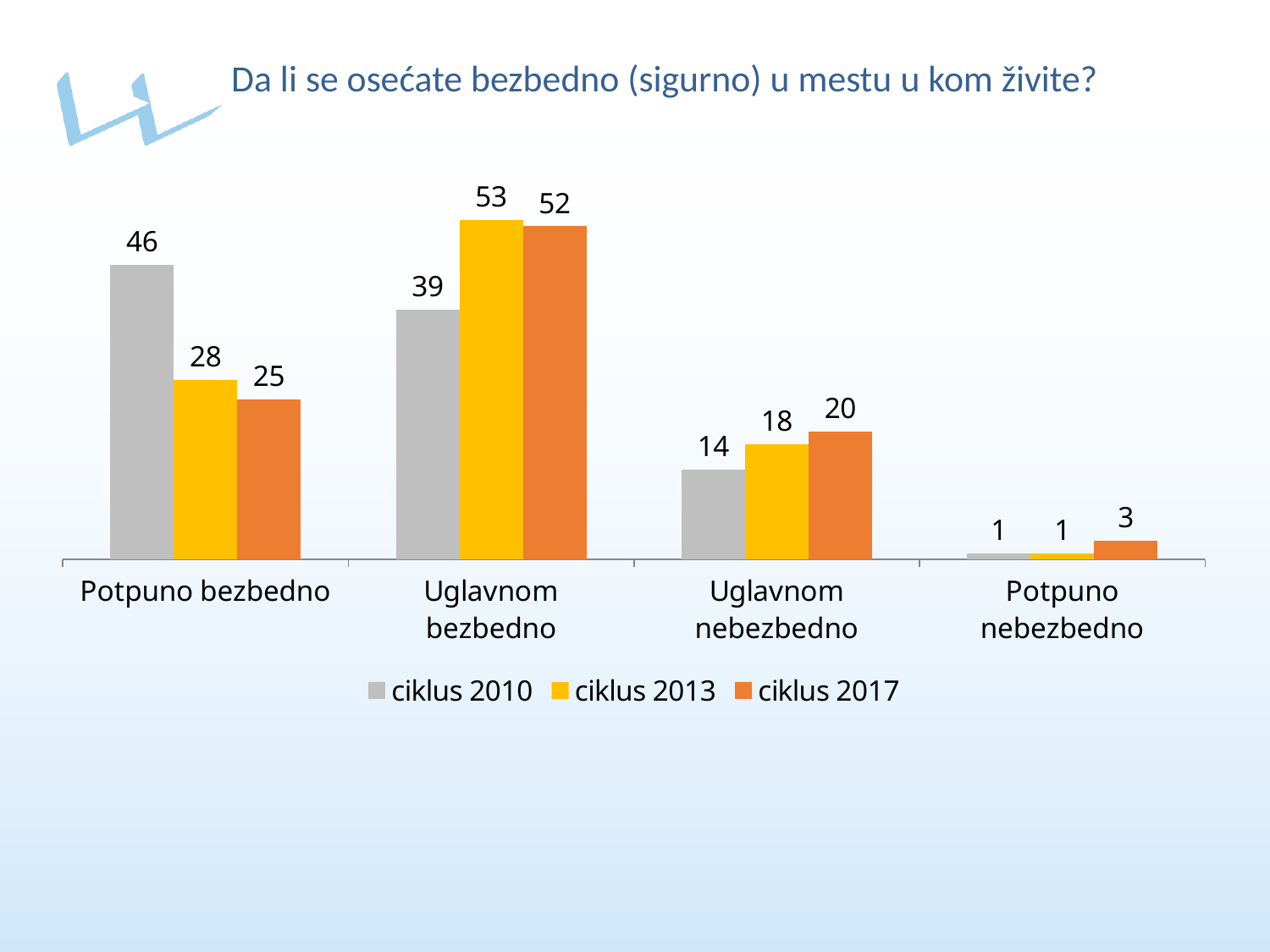
Which category has the highest value in the ciklus 2013 series? Uglavnom bezbedno Which series is shown in orange in the legend? ciklus 2017 What is the value for 'Uglavnom bezbedno' in the ciklus 2017 series? 52 Which is larger for 'Uglavnom nebezbedno': the ciklus 2010 value or the ciklus 2017 value? ciklus 2017 How many series does the legend list? 3 Which category has the lowest value in the ciklus 2010 series? Potpuno nebezbedno How many categories are shown on the x axis? 4 What kind of chart is shown on the slide? bar chart What is the value for 'Uglavnom nebezbedno' in the ciklus 2013 series? 18 What is the value for 'Potpuno bezbedno' in the ciklus 2010 series? 46 What is the value for 'Potpuno nebezbedno' in the ciklus 2017 series? 3 What is the difference between the ciklus 2010 and ciklus 2017 values for 'Potpuno bezbedno'? 21